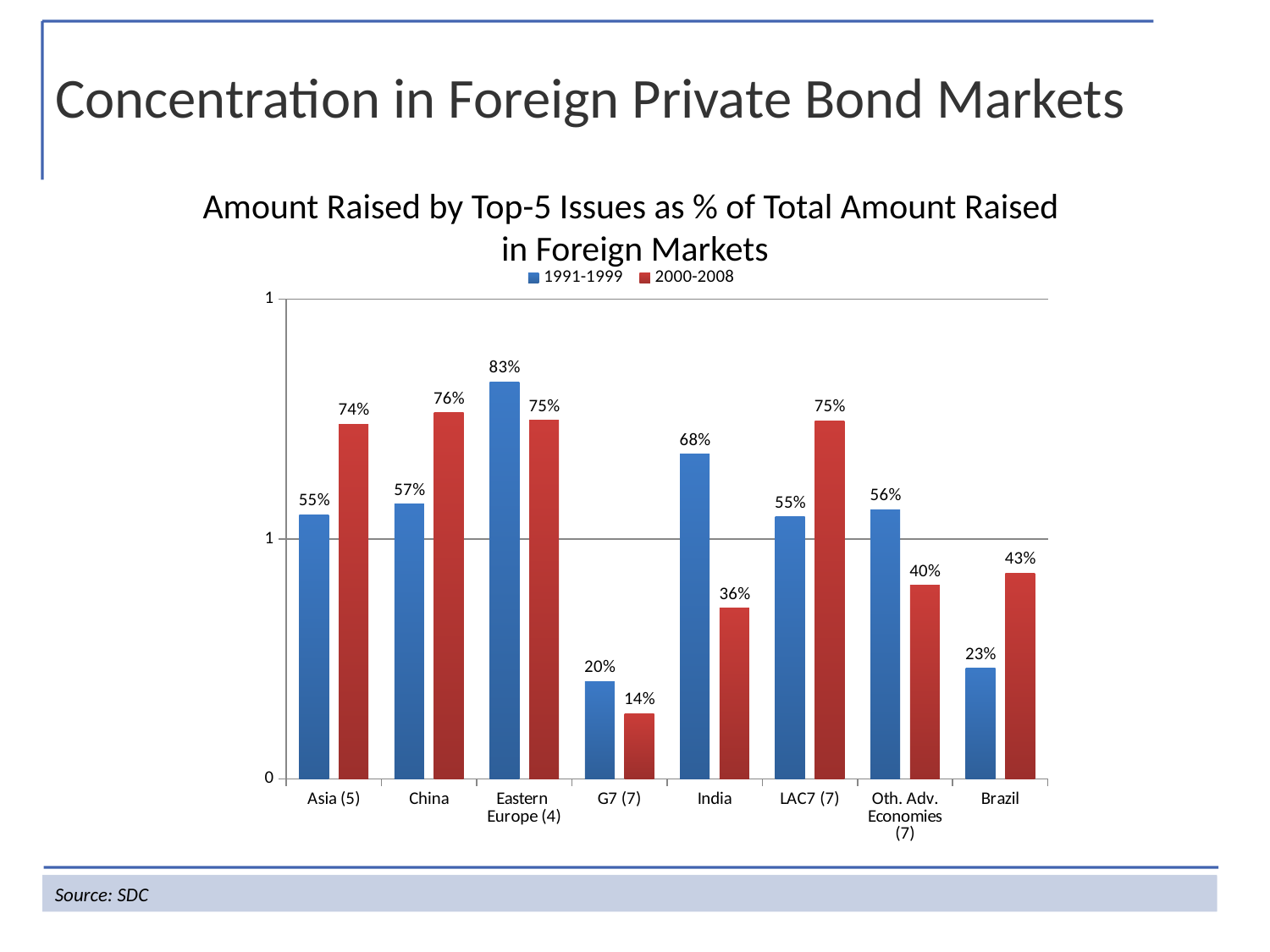
What kind of chart is shown on the slide? Bar chart How many series does the legend list? 2 Which colour represents the 2000-2008 series? Red What is the value for India in the 1991-1999 series? 68% Which category has the highest value in the 1991-1999 series? Eastern Europe (4) What is the difference between the 1991-1999 and 2000-2008 values for India? 32% What is the difference between the 2000-2008 and 1991-1999 values for Asia (5)? 19% Which is larger for Oth. Adv. Economies (7): the 1991-1999 value or the 2000-2008 value? 1991-1999 How many categories are shown on the x axis? 8 What is the value for China in the 2000-2008 series? 76% What is the value for Brazil in the 2000-2008 series? 43% Which category has the lowest value in the 2000-2008 series? G7 (7)